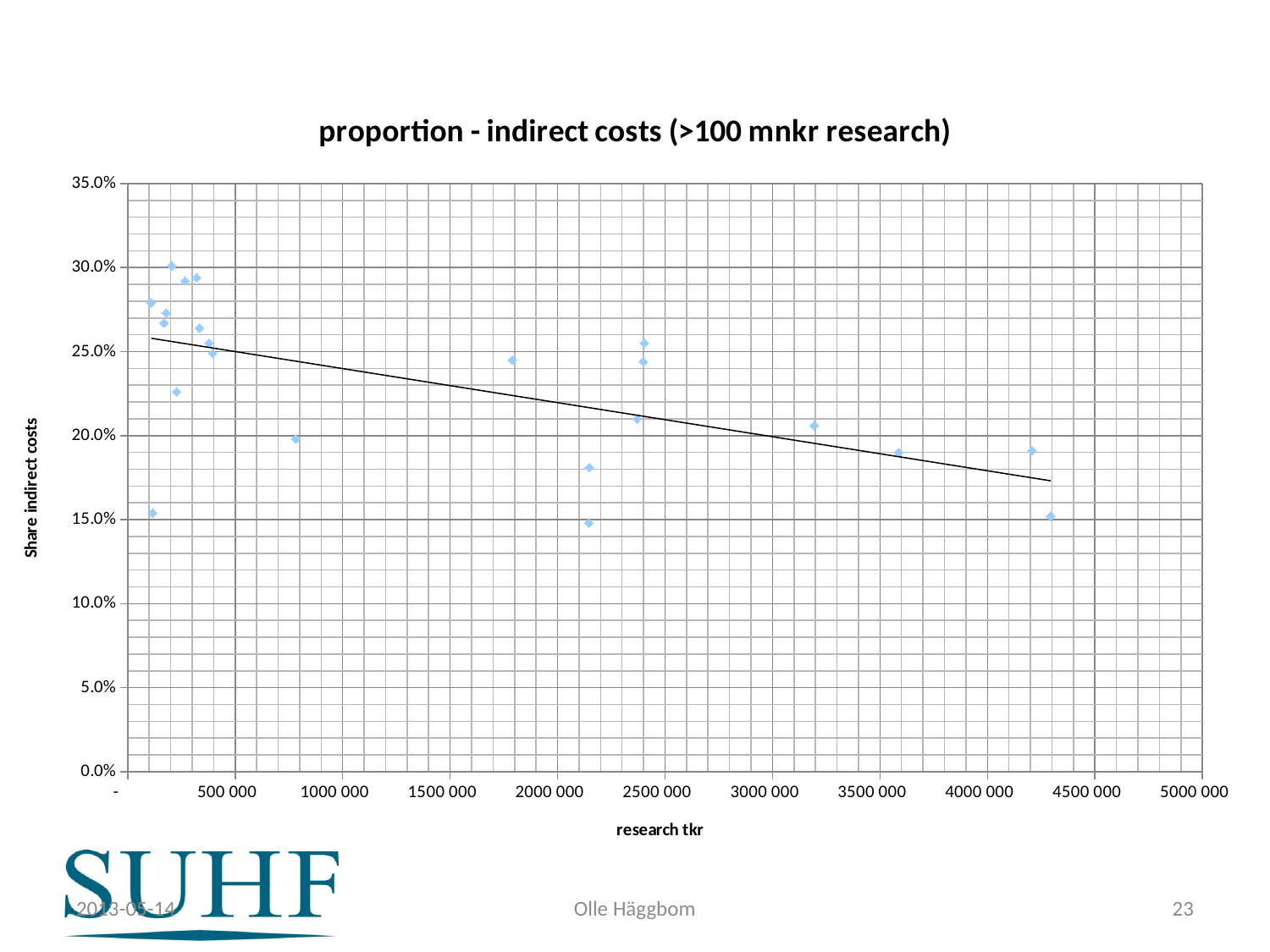
What is the title of the chart? proportion - indirect costs (>100 mnkr research) Is the share of indirect costs for the point at about 3 600 000 research tkr greater or less than 25.0%? less Is the share of indirect costs for the point at about 4 350 000 research tkr greater or less than 20.0%? less What is the maximum value shown on the vertical axis? 35.0% Is the share of indirect costs for the point at about 1 800 000 research tkr greater or less than 20.0%? greater What is the label of the vertical axis? Share indirect costs What kind of chart is shown on the slide? scatter chart Is the highest share of indirect costs on the chart found at research below or above 500 000 tkr? below According to the trend line, does the share of indirect costs rise or fall as research tkr increases? fall